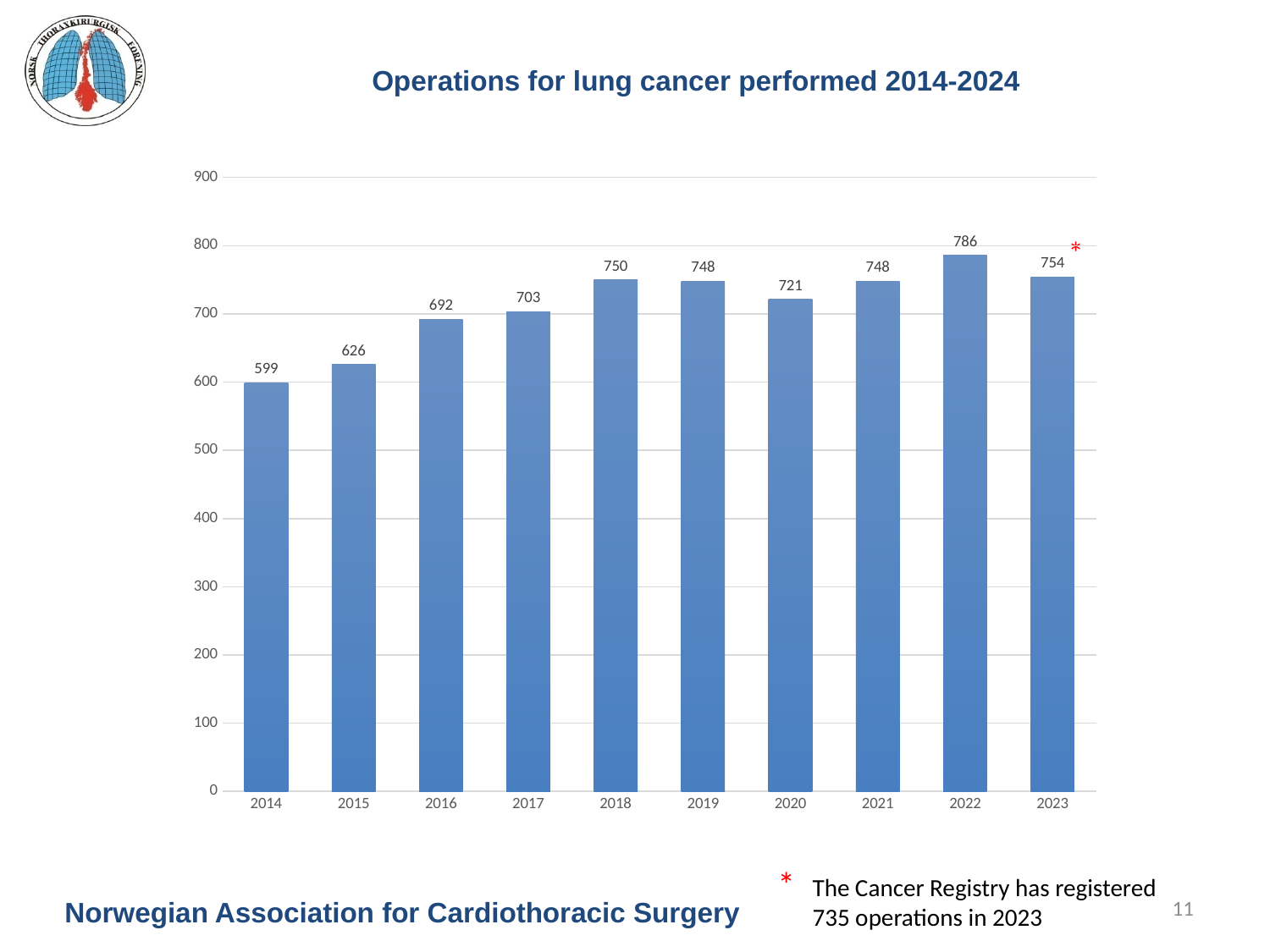
What is the title of the chart? Operations for lung cancer performed 2014-2024 Is the value for 2015 greater or less than 600? greater Which is larger, the value for 2016 or the value for 2017? 2017 What is the difference between the values for 2022 and 2014? 187 What is the difference between the values for 2023 and 2020? 33 What is the value shown for 2020? 721 Which year has the lowest number of operations? 2014 What is the value shown for 2023? 754 Which year has the highest number of operations? 2022 How many years are shown on the x axis? 10 How many operations for lung cancer were performed in 2014? 599 What kind of chart is shown on the slide? Bar chart